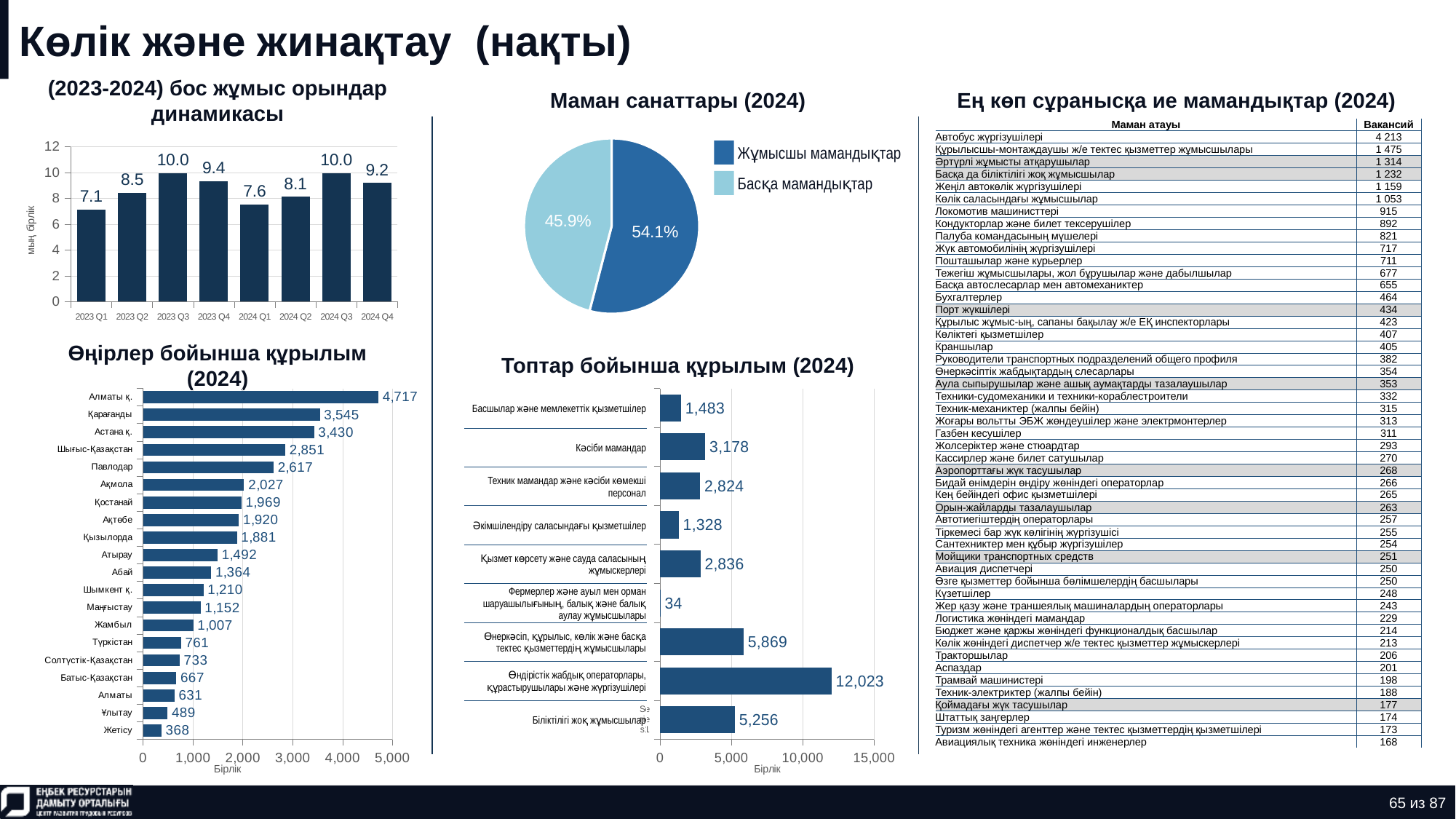
What kind of chart is 'Топтар бойынша құрылым (2024)'? Bar chart In the chart '(2023-2024) бос жұмыс орындар динамикасы', what is the value for 2023 Q1? 7.1 In the chart '(2023-2024) бос жұмыс орындар динамикасы', how many quarters are plotted? 8 In the chart '(2023-2024) бос жұмыс орындар динамикасы', which quarter has the lowest value? 2023 Q1 In the pie chart 'Маман санаттары (2024)', how many entries does the legend list? 2 In the chart 'Өңірлер бойынша құрылым (2024)', which region has the highest value? Алматы қ. In the chart 'Топтар бойынша құрылым (2024)', which group has the lowest value? Фермерлер және ауыл мен орман шаруашылығының, балық және балық аулау жұмысшылары In the chart '(2023-2024) бос жұмыс орындар динамикасы', what is the difference between 2024 Q3 and 2024 Q4? 0.8 In the pie chart 'Маман санаттары (2024)', what share does 'Жұмысшы мамандықтар' have? 54.1% In the chart 'Өңірлер бойынша құрылым (2024)', what is the value for Жетісу? 368 In the chart 'Өңірлер бойынша құрылым (2024)', what is the difference between Алматы қ. and Қарағанды? 1,172 In the chart 'Өңірлер бойынша құрылым (2024)', how many regions are shown? 20